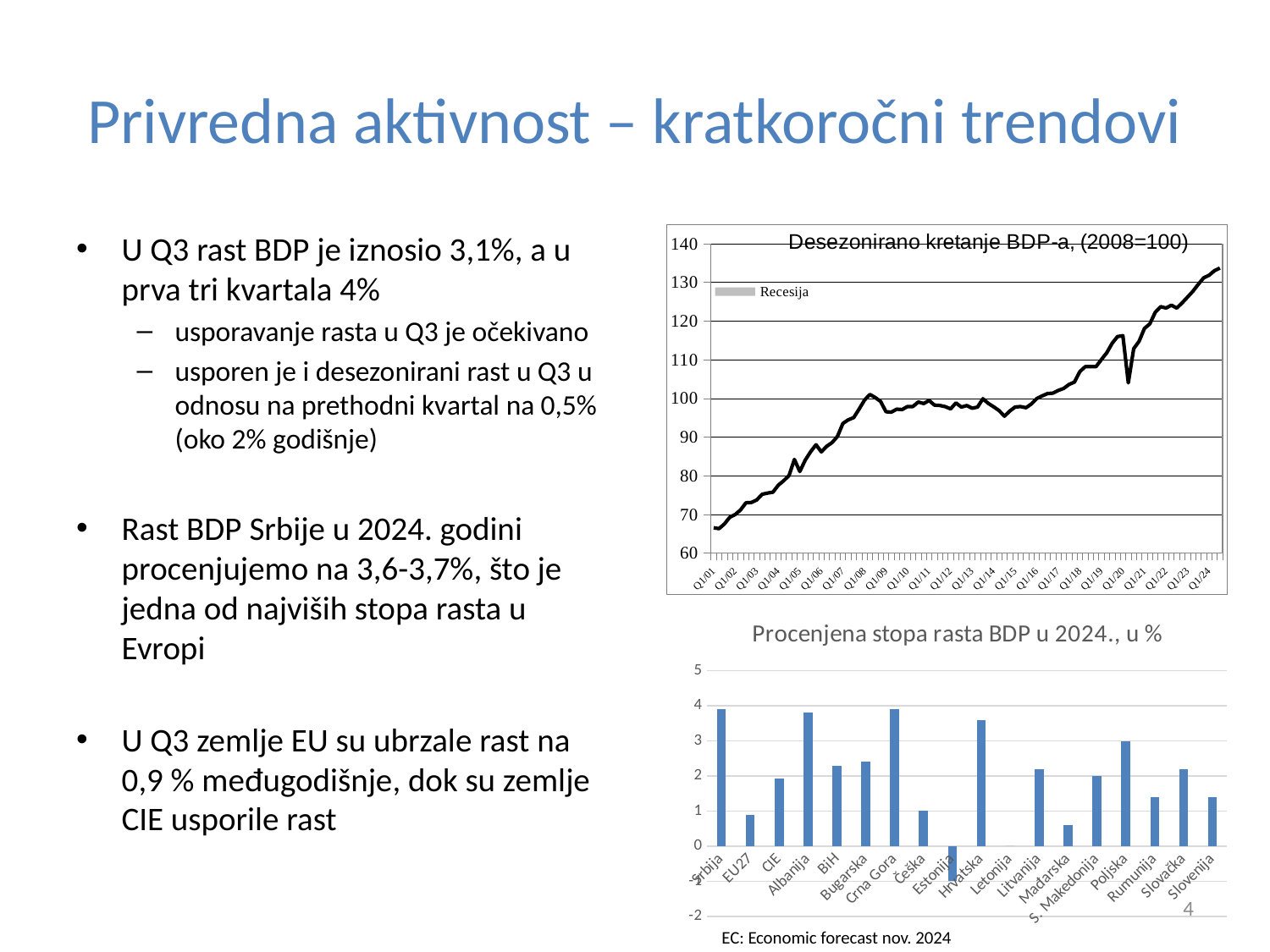
In the top chart 'Desezonirano kretanje BDP-a', is the value at Q1/24 greater or less than 130? greater What kind of chart is the bottom chart titled 'Procenjena stopa rasta BDP u 2024., u %'? bar chart In the top chart 'Desezonirano kretanje BDP-a', is the value at Q1/01 greater or less than 70? less In the bottom chart 'Procenjena stopa rasta BDP u 2024., u %', is the value for EU27 greater or less than 2? less How many countries/categories are shown on the x axis of the bottom chart 'Procenjena stopa rasta BDP u 2024., u %'? 18 In the top chart 'Desezonirano kretanje BDP-a', do the values overall rise or fall from Q1/01 to Q1/24? rise What kind of chart is the top chart titled 'Desezonirano kretanje BDP-a, (2008=100)'? line chart What entry does the legend of the top chart 'Desezonirano kretanje BDP-a' list? Recesija In the bottom chart 'Procenjena stopa rasta BDP u 2024., u %', which country has the lowest value? Estonija In the bottom chart 'Procenjena stopa rasta BDP u 2024., u %', which is larger, the value for Hrvatska or the value for Češka? Hrvatska